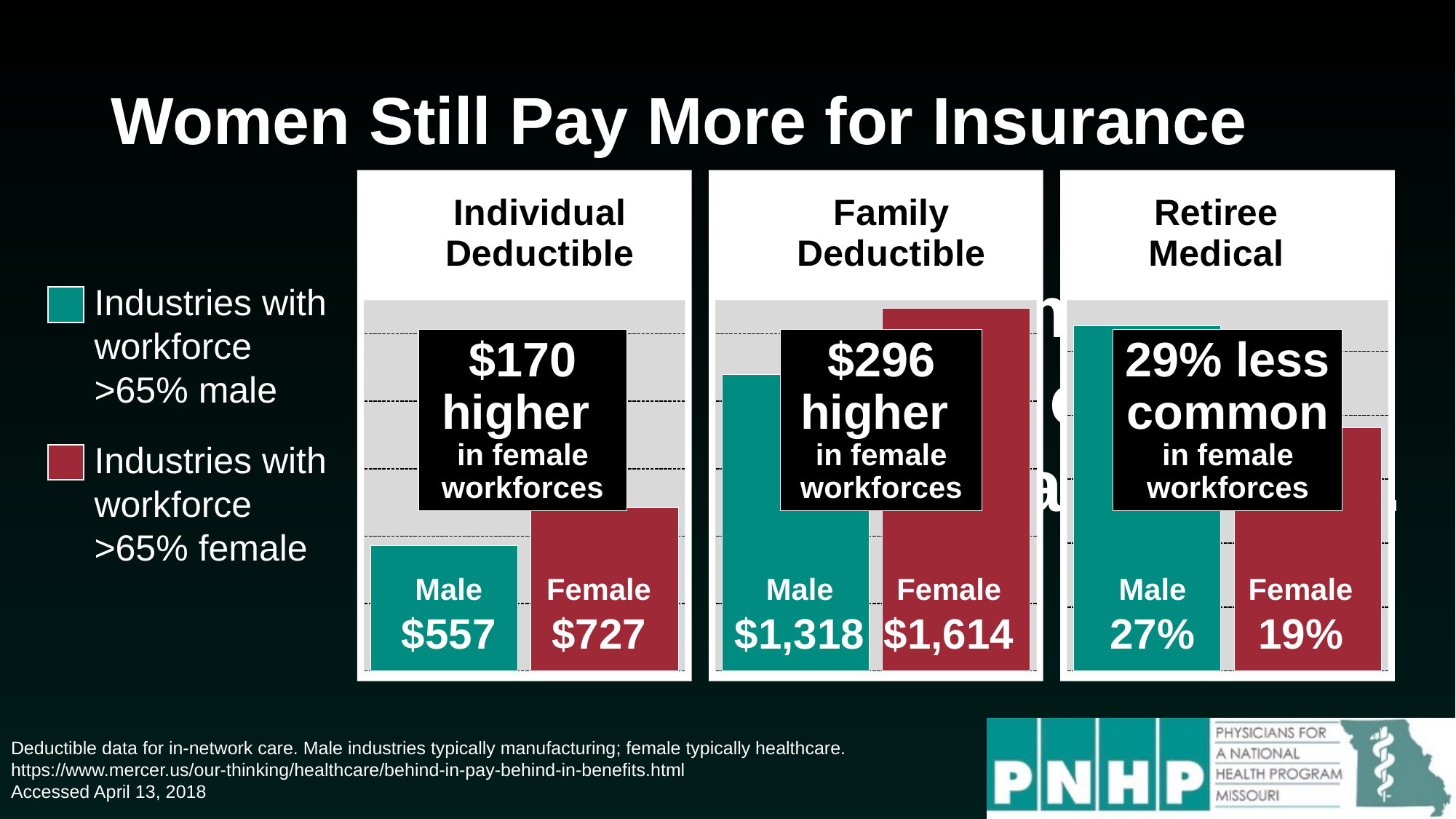
In the Retiree Medical chart, which is larger, the Male or the Female value? Male In the Individual Deductible chart, what is the value for Female? $727 In the Retiree Medical chart, what is the value for Male? 27% In the Family Deductible chart, what is the value for Female? $1,614 In the Individual Deductible chart, what is the value for Male? $557 In the Family Deductible chart, which category has the highest value? Female In the Family Deductible chart, what is the value for Male? $1,318 In the Individual Deductible chart, what is the difference between the Female and Male values? $170 In the Retiree Medical chart, what is the value for Female? 19% How many bars are in the Retiree Medical chart? 2 What kind of chart is the Individual Deductible chart? Bar chart In the Family Deductible chart, what is the difference between the Female and Male values? $296